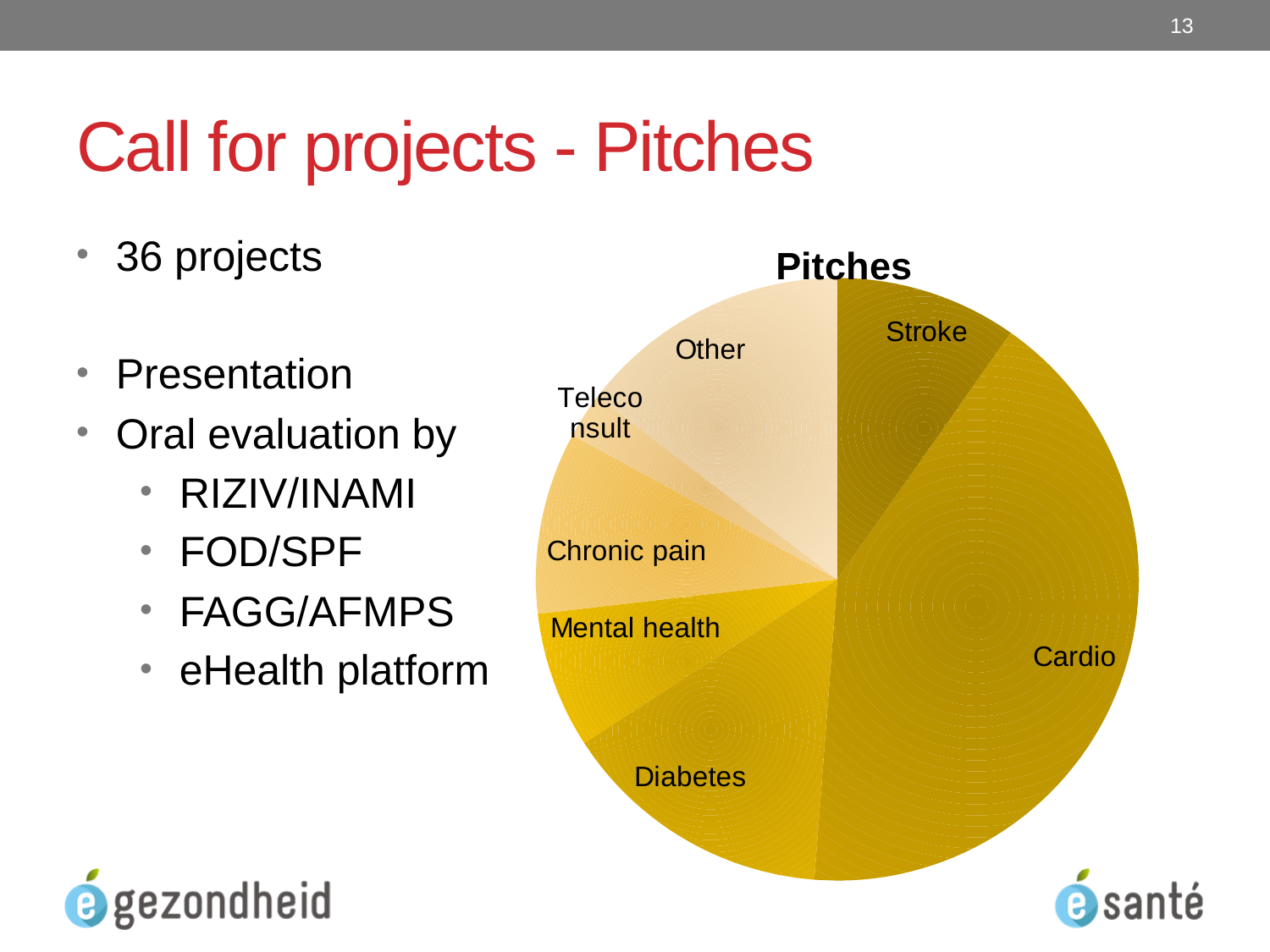
Which slice is larger, Cardio or Stroke? Cardio Which category has the largest slice of the pie chart? Cardio Which slice is larger, Cardio or Diabetes? Cardio Which slice is larger, Other or Stroke? Other What kind of chart is shown on the slide? Pie chart What is the title of the chart? Pitches How many slices does the pie chart have? 7 Which category's slice is located between Stroke and Diabetes on the pie chart? Cardio